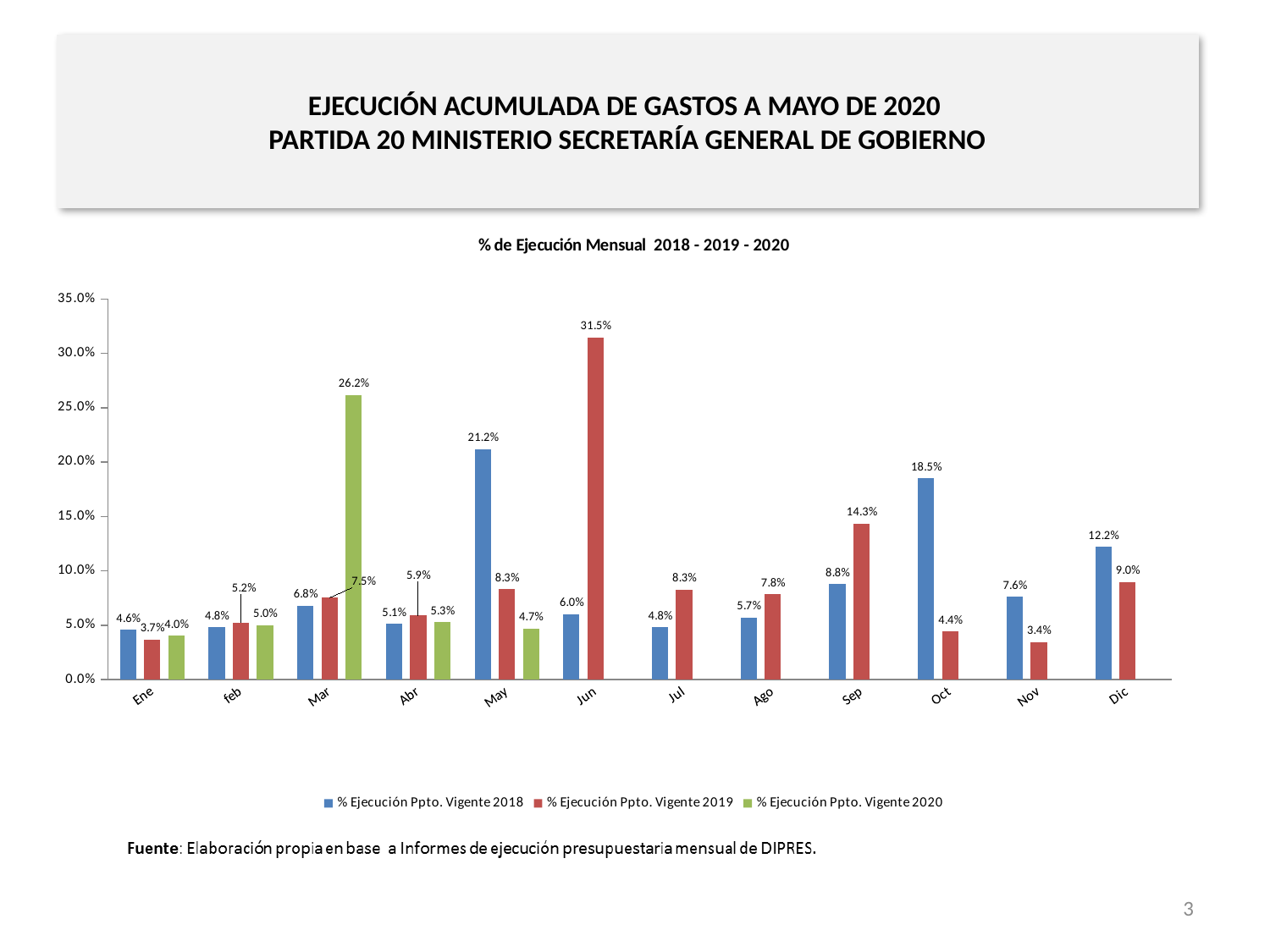
What is the title of the chart? % de Ejecución Mensual 2018 - 2019 - 2020 Is the value for % Ejecución Ppto. Vigente 2019 in Jun greater or less than 30.0%? greater What is the difference between the 2019 and 2018 values in Sep? 5.5% Which month has the lowest value for % Ejecución Ppto. Vigente 2019? Nov How many series does the legend list? 3 Which is larger in Dic: the 2018 value or the 2019 value? 2018 value (12.2%) What is the value for % Ejecución Ppto. Vigente 2020 in Mar? 26.2% Which month has the highest value for % Ejecución Ppto. Vigente 2018? May How many months are shown on the x axis? 12 What is the value for % Ejecución Ppto. Vigente 2018 in Oct? 18.5% What is the value for % Ejecución Ppto. Vigente 2019 in Jun? 31.5% What kind of chart is shown on the slide? Bar chart